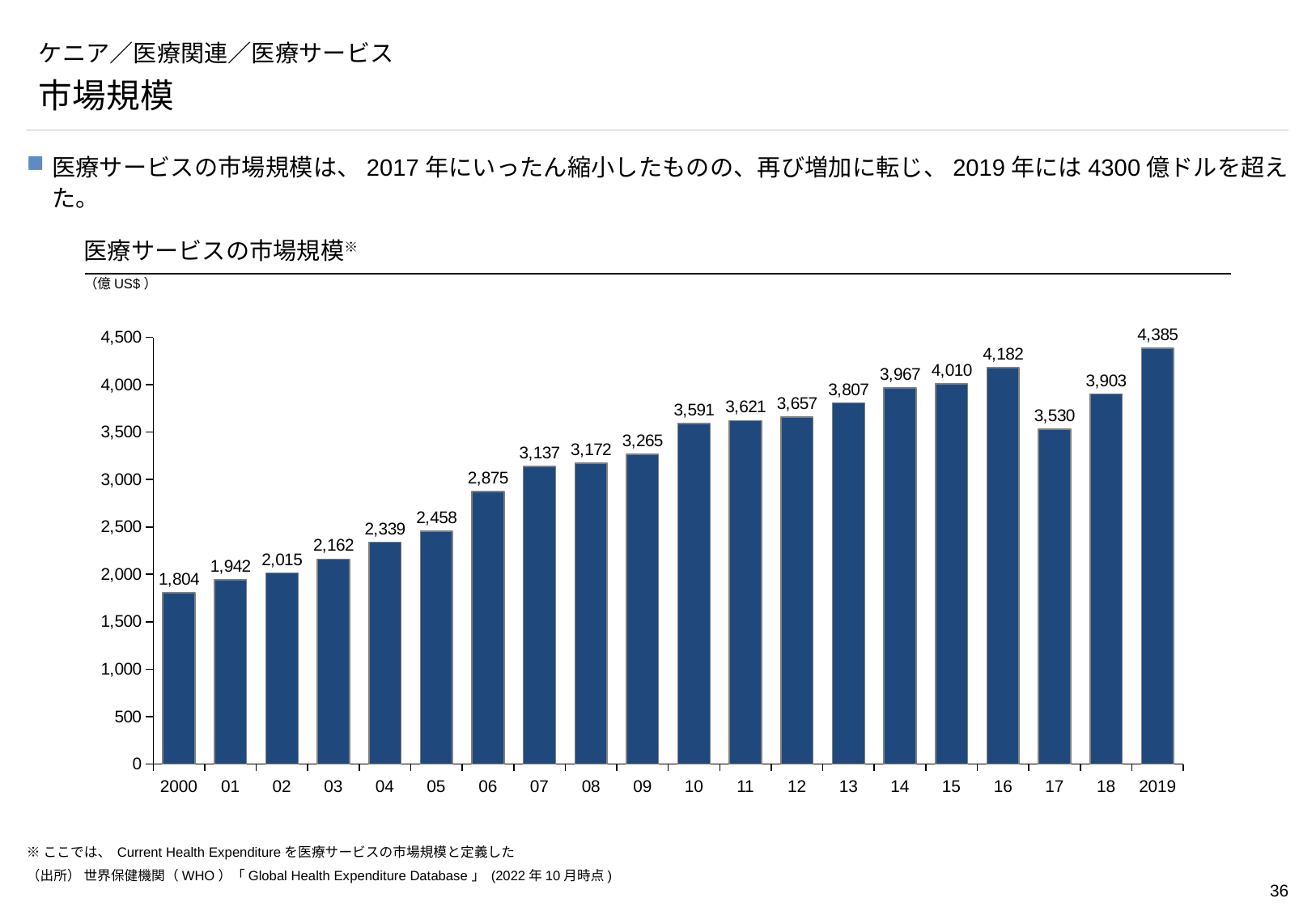
Which year has the lowest value? 2000 What is the value for 2019? 4,385 What kind of chart is this? bar chart How many years are shown on the x axis? 20 Which year has the highest value? 2019 Do the values generally rise or fall from 2000 to 16? rise What is the difference between the values for 2019 and 18? 482 Which is larger, the value for 16 or the value for 17? 16 What unit is shown for the chart values? 億US$ What is the value for 2000? 1,804 What is the value for 17? 3,530 Is the value for 10 greater or less than 3,500? greater